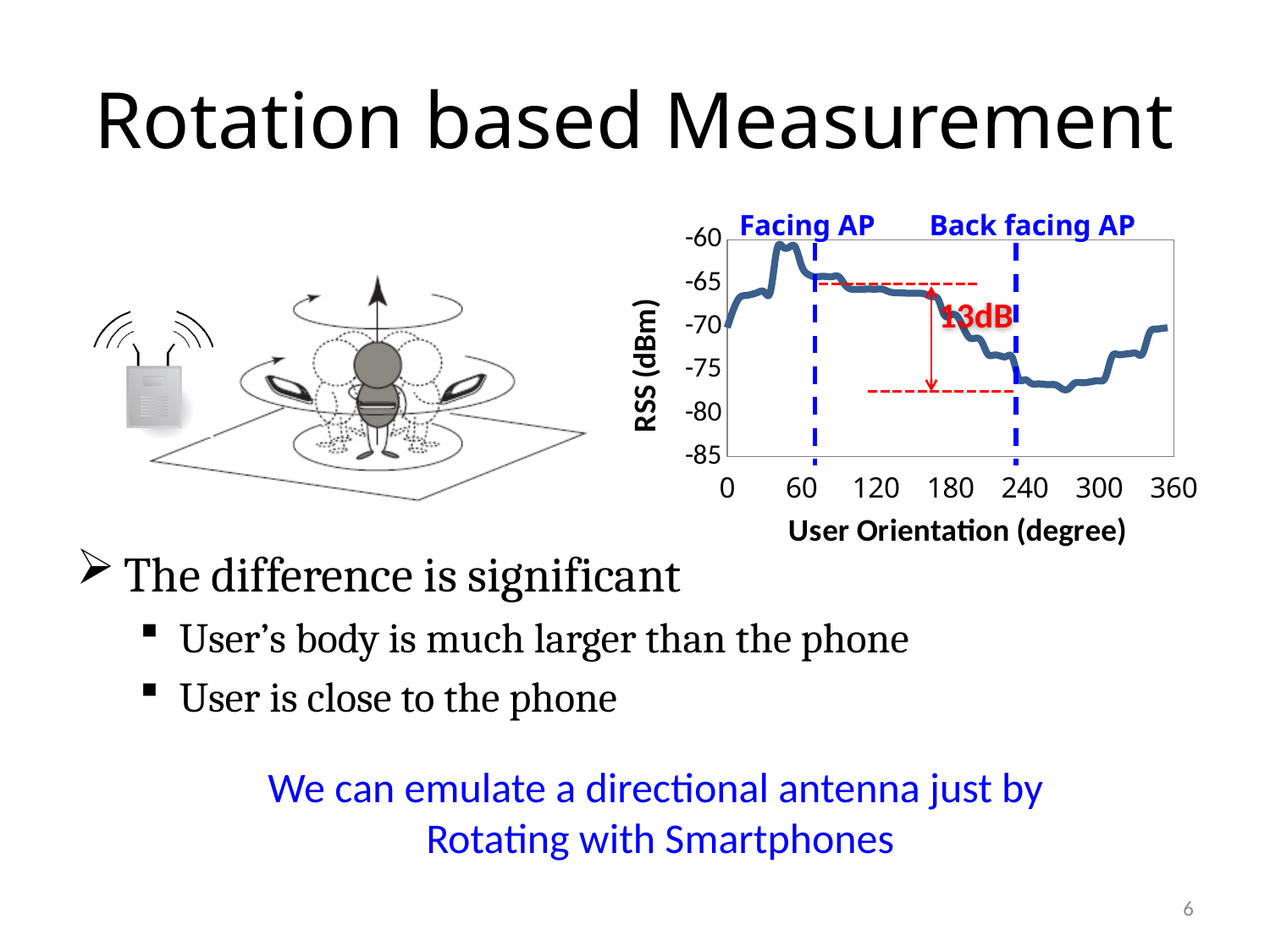
What kind of chart is shown on the slide? line chart Between user orientations of 240 and 360 degrees, does the RSS rise or fall? rise What is the label of the y axis of the chart? RSS (dBm) What is the label of the x axis of the chart? User Orientation (degree) Is the RSS value at a user orientation of 60 degrees greater or less than -65 dBm? greater Is the lowest RSS value on the chart greater or less than -75 dBm? less Is the RSS value at a user orientation of 270 degrees greater or less than -75 dBm? less Between user orientations of 60 and 240 degrees, does the RSS rise or fall? fall Which is larger, the RSS at 60 degrees or the RSS at 240 degrees? 60 degrees According to the annotation on the chart, what is the RSS difference between facing the AP and back facing the AP? 13dB